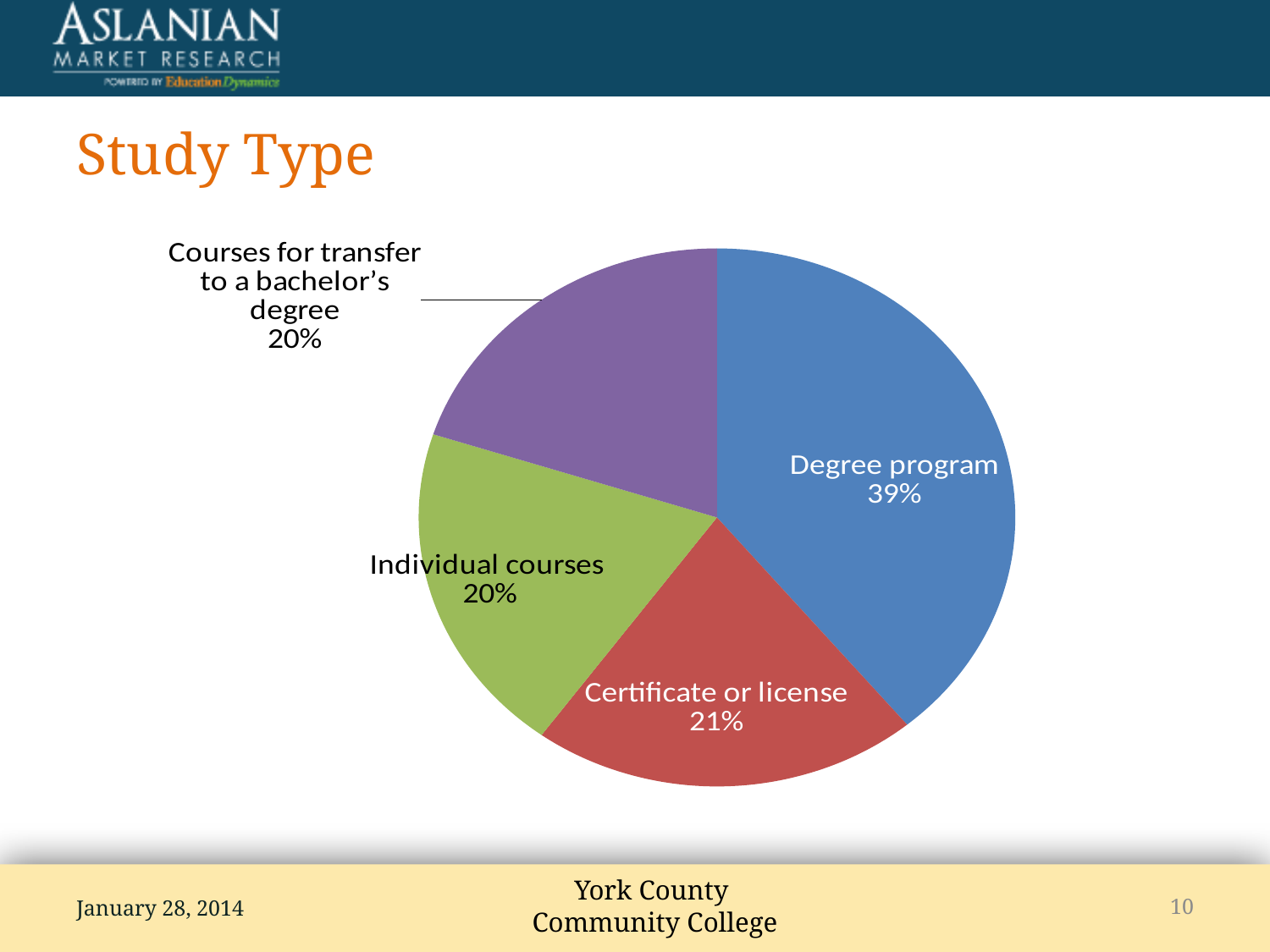
What is the title of the slide containing the pie chart? Study Type Which category has the largest share of the pie? Degree program What colour is the Degree program slice? Blue What percentage is shown for Certificate or license? 21% What percentage is shown for Individual courses? 20% What share of the pie is Degree program? 39% Which is larger, Degree program or Individual courses? Degree program What percentage is shown for Courses for transfer to a bachelor's degree? 20% What is the difference in percentage points between Certificate or license and Individual courses? 1 What type of chart is shown on the slide? Pie chart How many slices does the pie chart have? 4 What is the difference in percentage points between Degree program and Certificate or license? 18